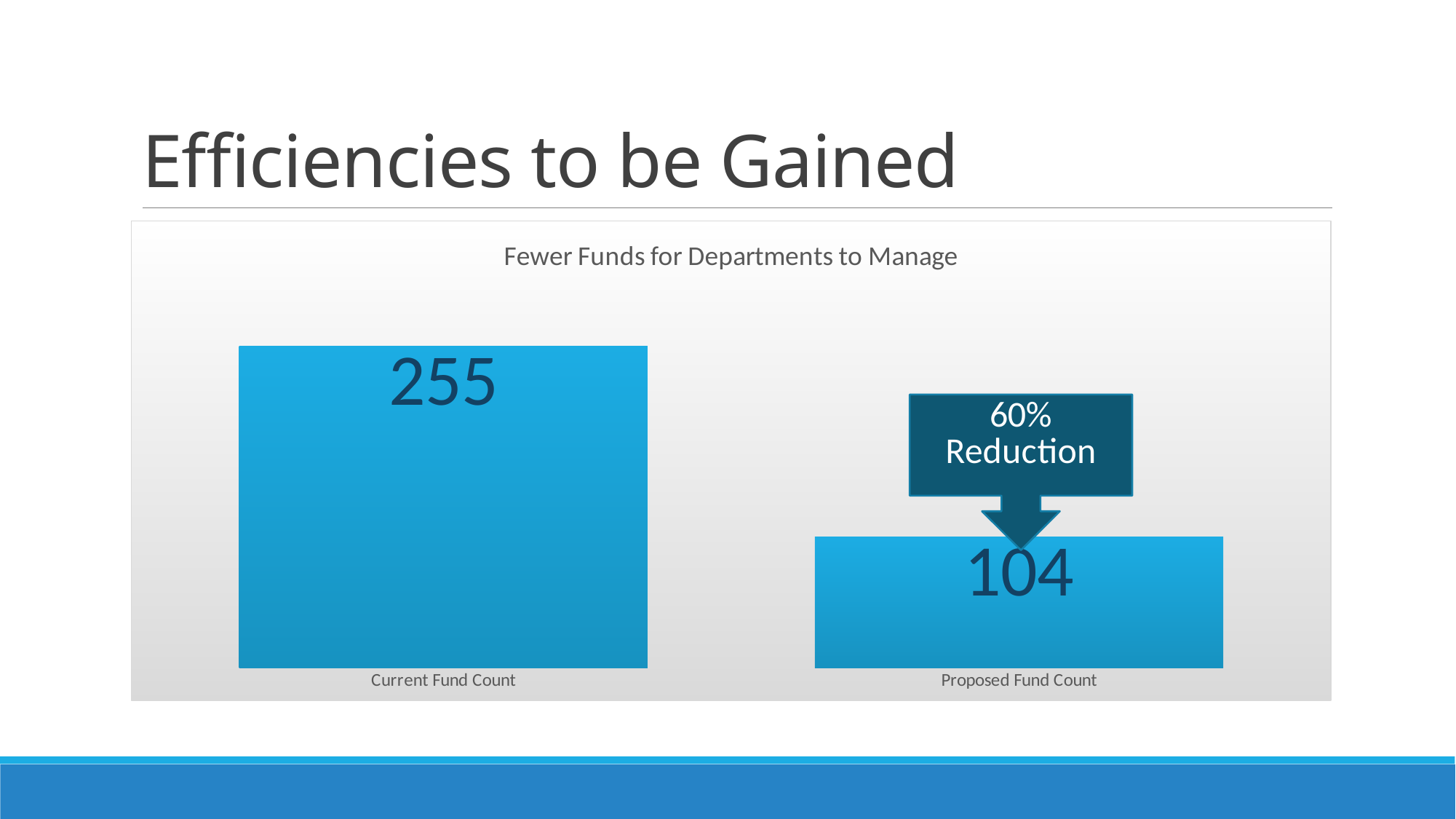
Do the values rise or fall from Current Fund Count to Proposed Fund Count? Fall How many categories are shown in the chart? 2 What percentage reduction does the callout on the chart state? 60% What is the value for Current Fund Count? 255 What kind of chart is shown on the slide? Bar chart What is the value for Proposed Fund Count? 104 Which category has the lowest value? Proposed Fund Count Which category has the highest value? Current Fund Count What is the difference between the Current Fund Count and the Proposed Fund Count? 151 Which is larger, the Current Fund Count or the Proposed Fund Count? Current Fund Count What is the title of the chart? Fewer Funds for Departments to Manage